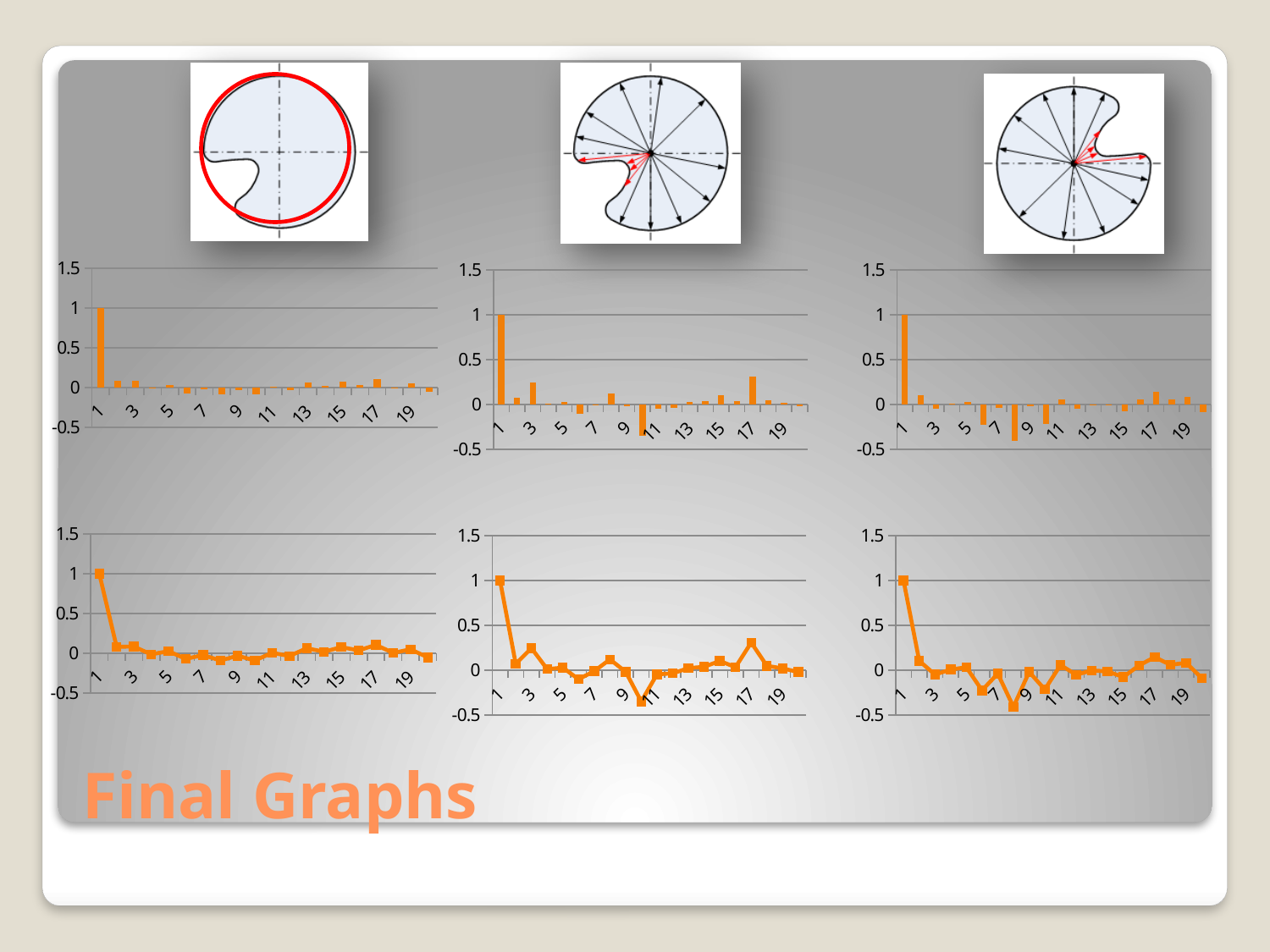
In the top-right bar chart, which category has the lowest value? 8 What is the highest value shown on the vertical axis of the top-left chart? 1.5 In the top-left bar chart, which category has the highest value? 1 In the bottom-left line chart, what is the value at point 1? 1 In the top-middle bar chart, which is larger, the value for category 17 or the value for category 11? 17 In the top-middle bar chart, is the value for category 1 greater or less than 0.5? greater In the top-middle bar chart, which category has the lowest value? 10 In the bottom-right line chart, do the values rise or fall from point 1 to point 3? fall What kind of chart is the bottom-middle chart on the slide? line chart What kind of chart is the top-left chart on the slide? bar chart In the bottom-right line chart, is the value at point 8 greater or less than 0? less